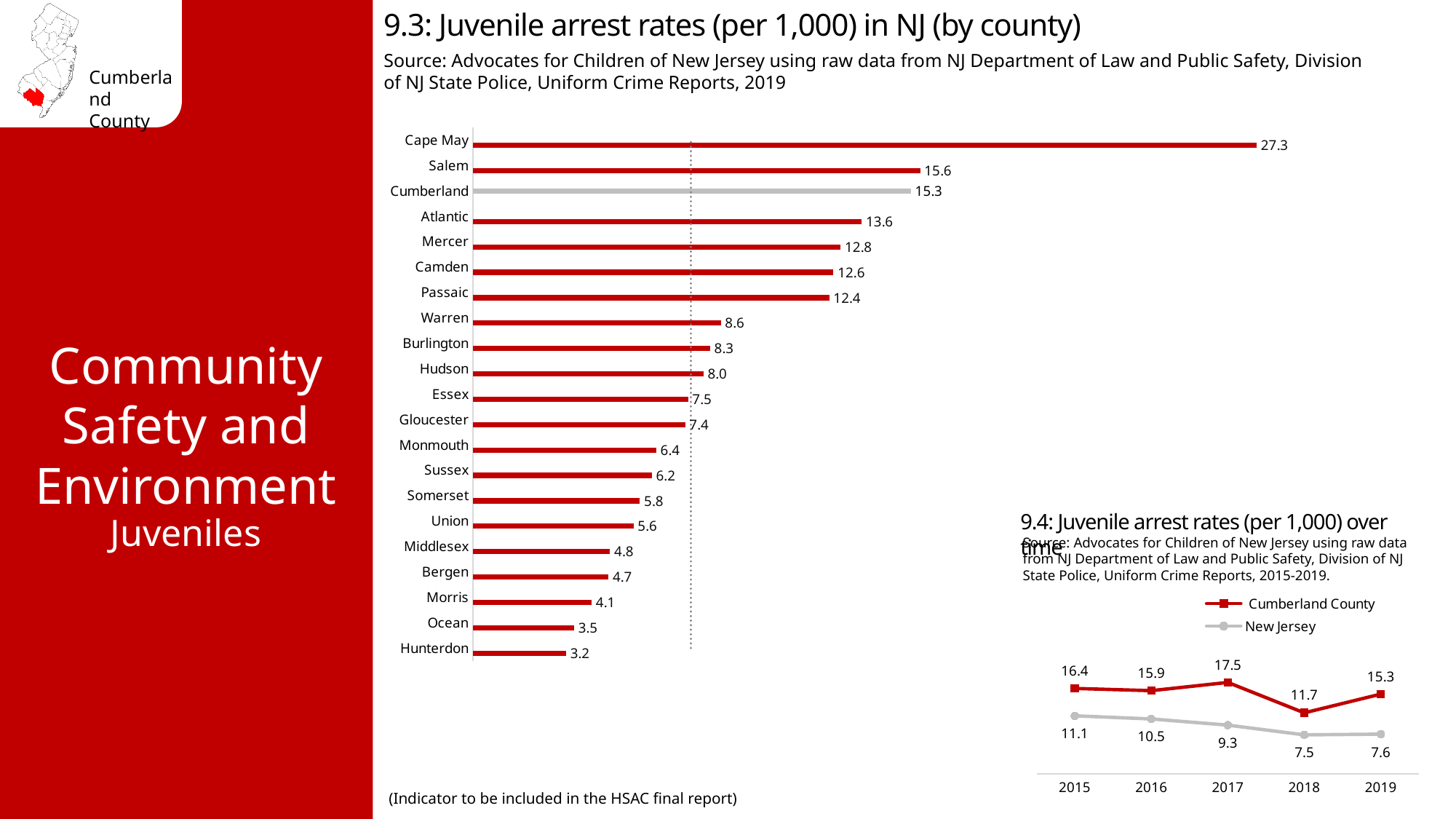
In the chart '9.3: Juvenile arrest rates (per 1,000) in NJ (by county)', how many counties are shown? 21 In the chart '9.3: Juvenile arrest rates (per 1,000) in NJ (by county)', what is the difference between the values for Cape May and Salem? 11.7 In the chart '9.4: Juvenile arrest rates (per 1,000) over time', what is the value for New Jersey in 2018? 7.5 In the chart '9.4: Juvenile arrest rates (per 1,000) over time', does the New Jersey series rise or fall from 2015 to 2018? fall In the chart '9.3: Juvenile arrest rates (per 1,000) in NJ (by county)', which is larger, the value for Mercer or the value for Passaic? Mercer In the chart '9.3: Juvenile arrest rates (per 1,000) in NJ (by county)', what is the value for Cumberland? 15.3 In the chart '9.3: Juvenile arrest rates (per 1,000) in NJ (by county)', which county has the highest value? Cape May In the chart '9.4: Juvenile arrest rates (per 1,000) over time', what is the difference between Cumberland County and New Jersey in 2019? 7.7 In the chart '9.4: Juvenile arrest rates (per 1,000) over time', what is the value for Cumberland County in 2017? 17.5 What kind of chart is '9.3: Juvenile arrest rates (per 1,000) in NJ (by county)'? bar chart In the chart '9.3: Juvenile arrest rates (per 1,000) in NJ (by county)', which county has the lowest value? Hunterdon In the chart '9.4: Juvenile arrest rates (per 1,000) over time', how many series does the legend list? 2